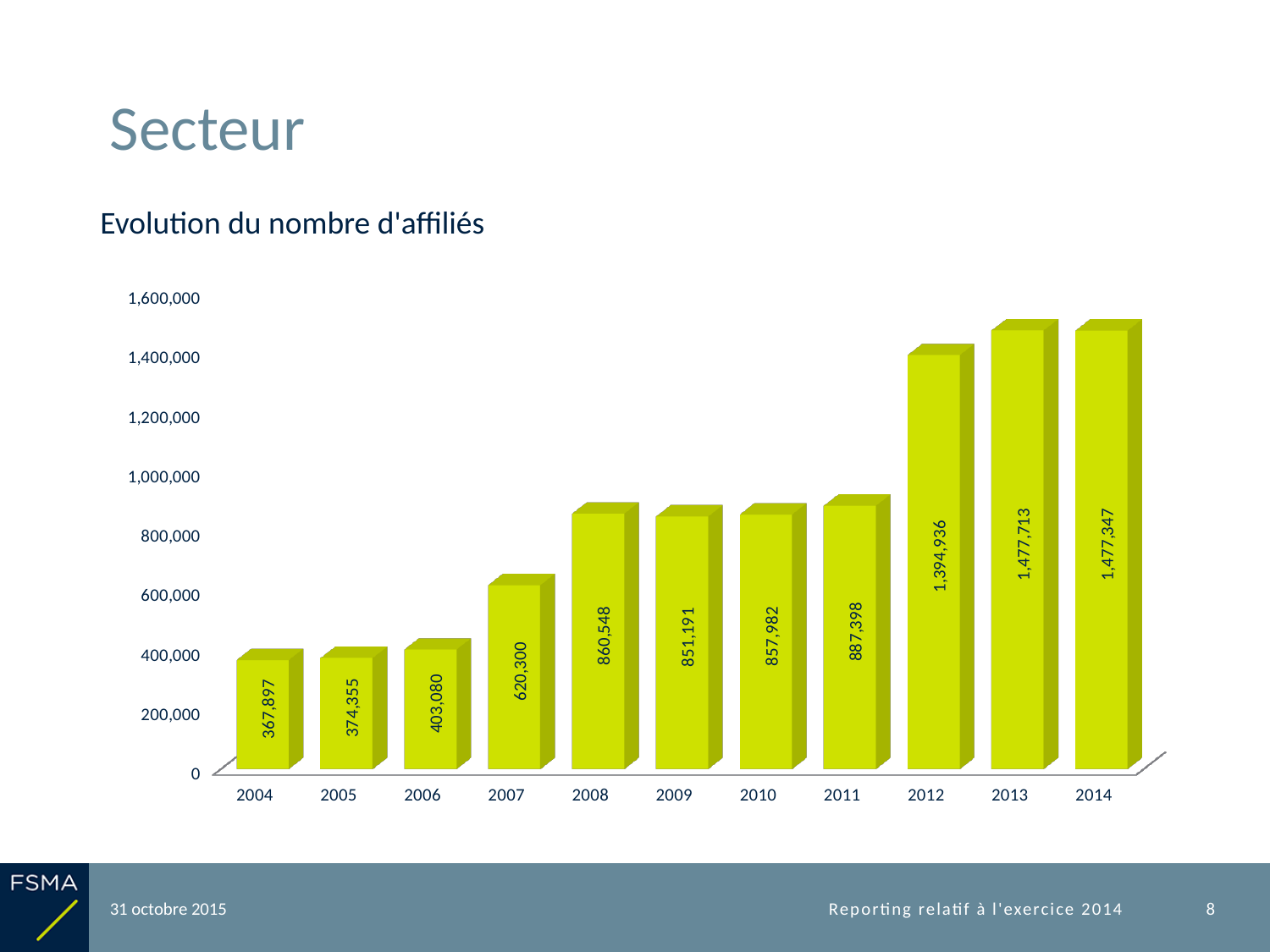
What is the difference between the values for 2012 and 2011? 507,538 Which is larger, the value for 2008 or the value for 2009? 2008 How many years are shown on the x axis? 11 Which year has the lowest value? 2004 What is the value for 2007? 620,300 What is the title of the chart? Evolution du nombre d'affiliés What is the value for 2012? 1,394,936 What is the value for 2004? 367,897 Is the value for 2011 greater or less than 800,000? greater What is the difference between the values for 2014 and 2004? 1,109,450 Do the values generally rise or fall from 2004 to 2014? rise What kind of chart is shown on the slide? bar chart